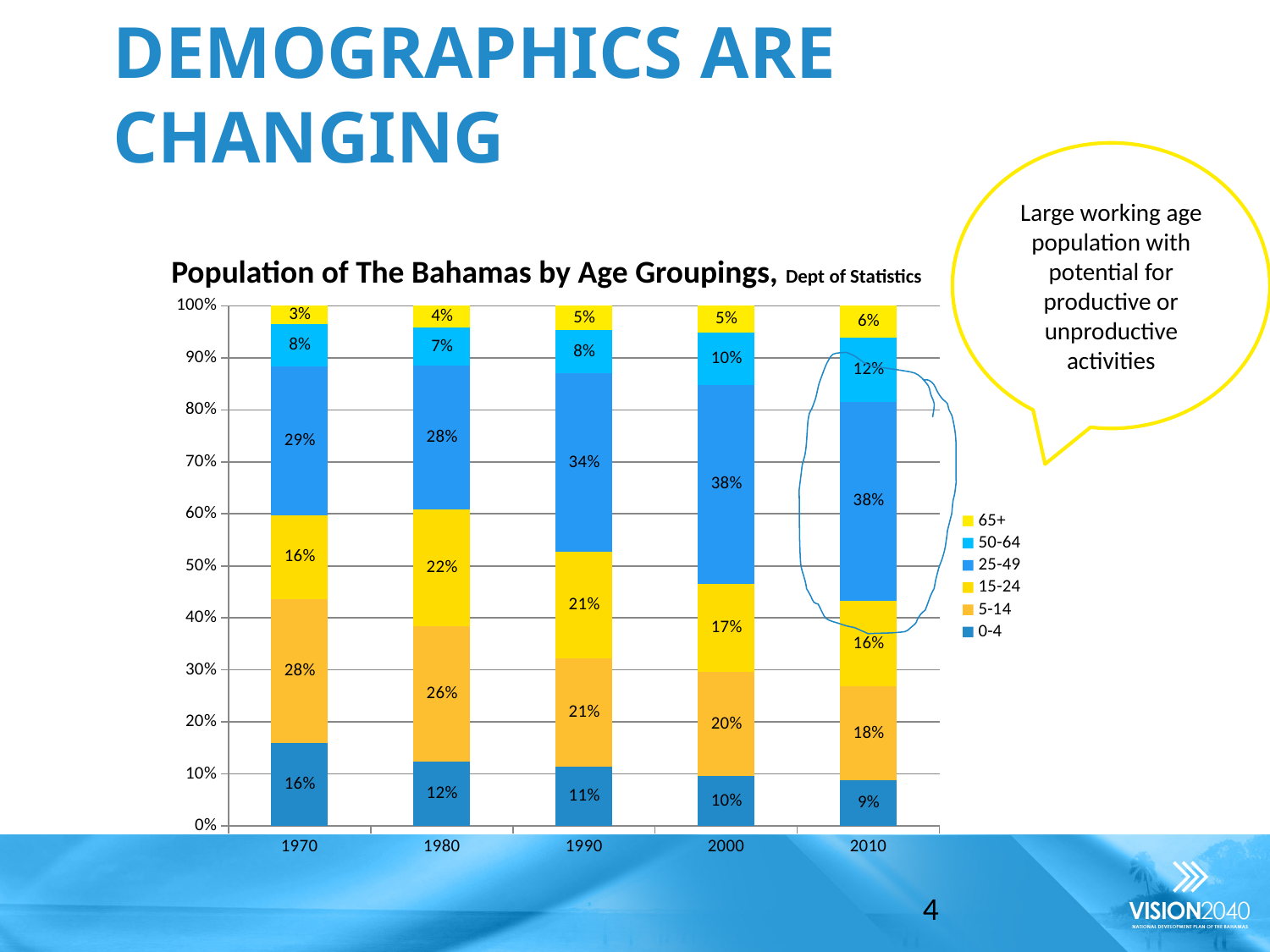
In which year was the 65+ share of the population highest? 2010 Does the 0-4 share of the population rise or fall from 1970 to 2010? Fall What kind of chart is shown on the slide? Stacked bar chart How many years are shown on the x axis? 5 How many age groupings does the legend list? 6 What percentage of the population was aged 0-4 in 1970? 16% Which was larger in 1980: the 15-24 share or the 25-49 share? 25-49 In which year was the 0-4 share of the population lowest? 2010 What percentage of the population was aged 25-49 in 2010? 38% What percentage of the population was aged 50-64 in 2000? 10% What is the difference between the 5-14 share in 1970 and the 5-14 share in 2010? 10% What is the title of the chart? Population of The Bahamas by Age Groupings, Dept of Statistics